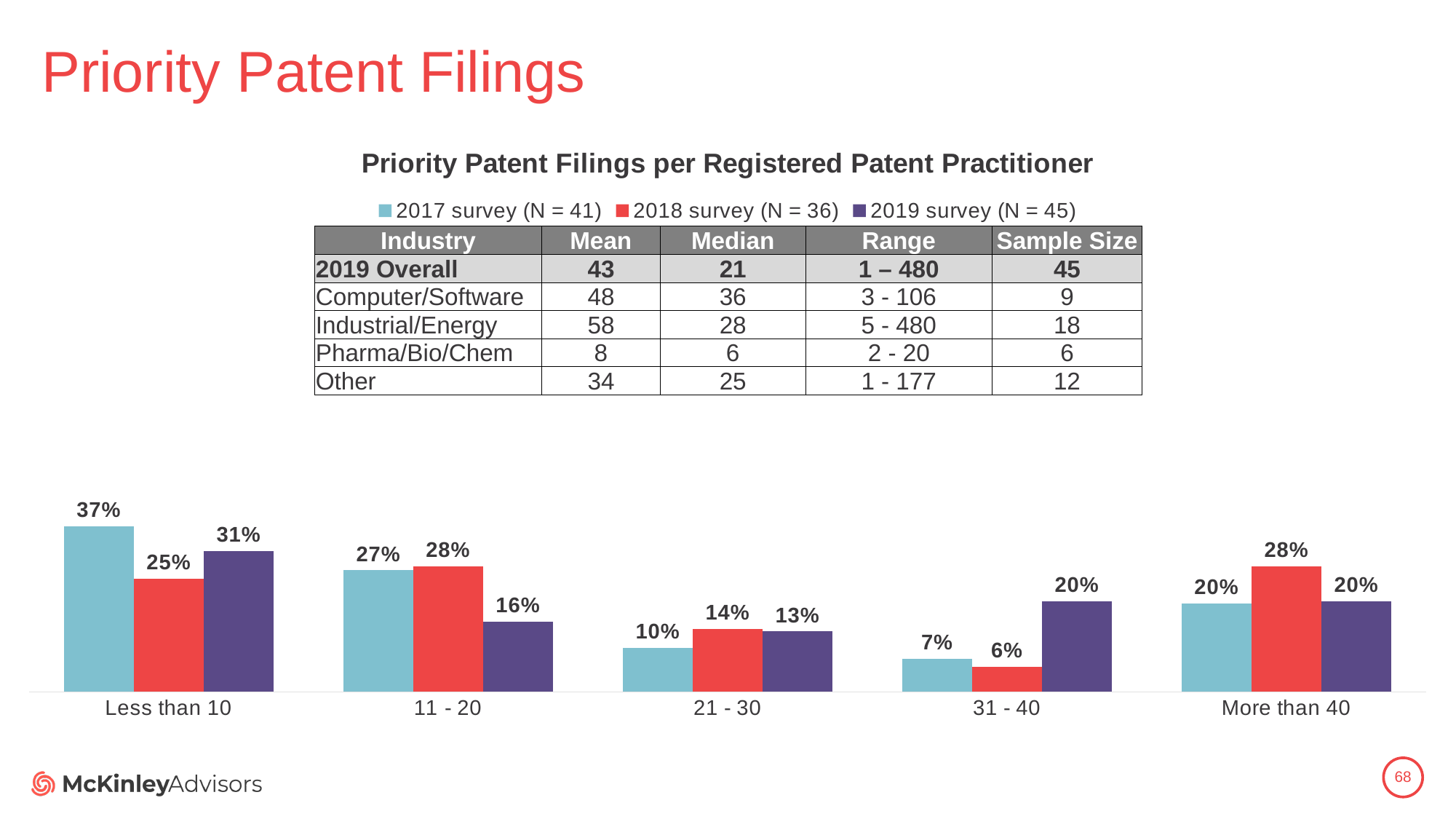
How many categories are shown on the x axis of the chart? 5 Which category has the lowest value for the 2018 survey? 31 - 40 What is the value for the 2019 survey in the '31 - 40' category? 20% What kind of chart is shown on the slide? Bar chart What is the difference between the 2017 survey and 2019 survey values in the '11 - 20' category? 11% What is the title of the chart? Priority Patent Filings per Registered Patent Practitioner Which is larger in the 'More than 40' category: the 2018 survey value or the 2019 survey value? 2018 survey Which category has the highest value for the 2017 survey? Less than 10 What is the value for the 2018 survey in the '21 - 30' category? 14% What is the sample size (N) for the 2019 survey shown in the legend? 45 What is the value for the 2017 survey in the 'Less than 10' category? 37% How many series does the chart legend list? 3